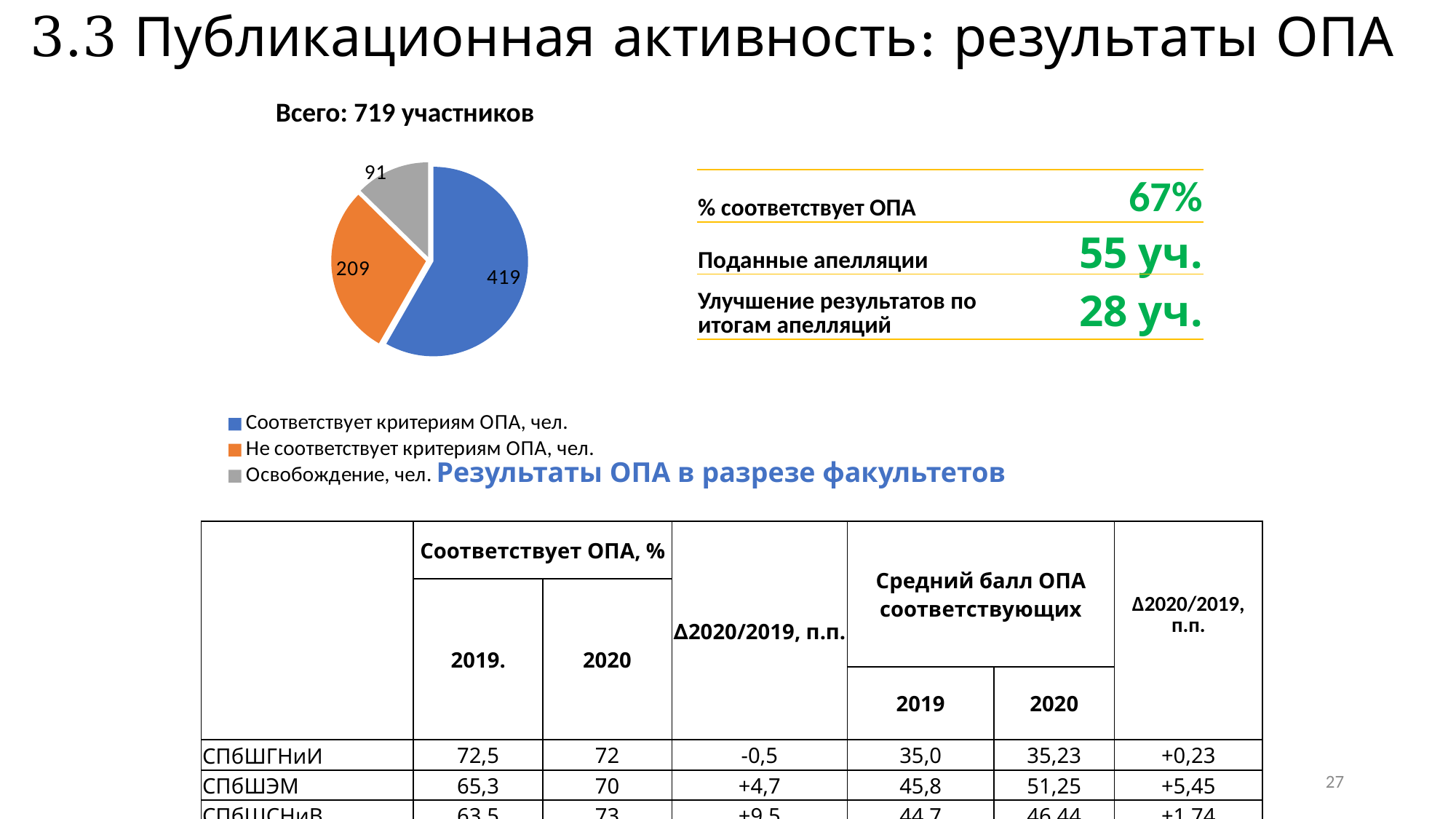
What colour is the "Освобождение, чел." slice in the pie chart? grey Which is larger in the pie chart: "Не соответствует критериям ОПА, чел." or "Освобождение, чел."? Не соответствует критериям ОПА, чел. Which category has the largest slice in the pie chart? Соответствует критериям ОПА, чел. What is the total number of participants shown above the pie chart? 719 What is the value for "Освобождение, чел." in the pie chart? 91 How many entries does the pie chart's legend list? 3 How many slices does the pie chart have? 3 What is the value for "Соответствует критериям ОПА, чел." in the pie chart? 419 Which category has the smallest slice in the pie chart? Освобождение, чел. What is the difference between the "Соответствует критериям ОПА" and "Не соответствует критериям ОПА" values in the pie chart? 210 What is the value for "Не соответствует критериям ОПА, чел." in the pie chart? 209 What type of chart is shown on the slide? pie chart